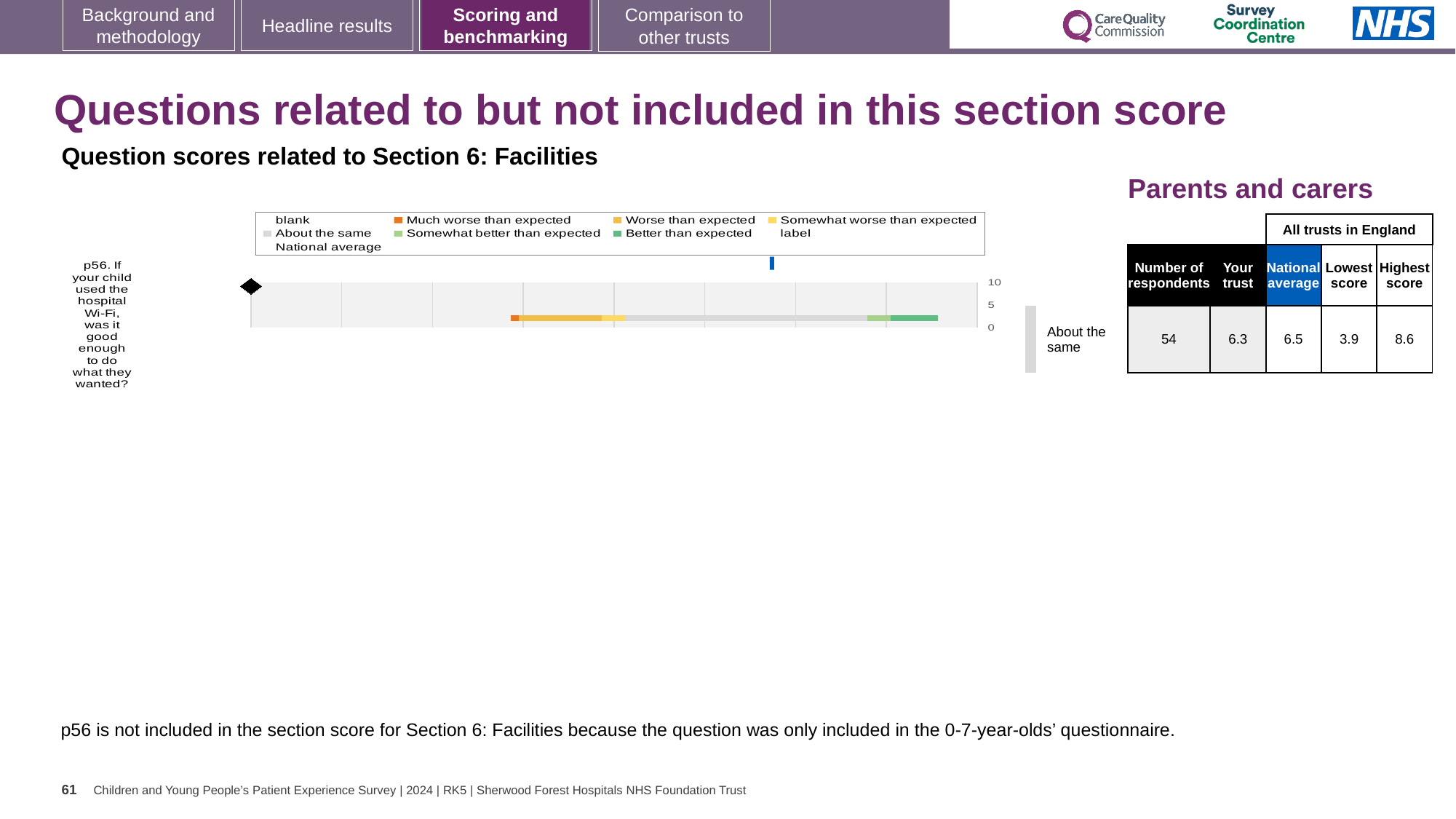
Which benchmarking category is the trust's result for p56 placed in? About the same What is the national average score for p56? 6.5 How many respondents answered p56? 54 What kind of chart is shown on the slide? bar chart How many survey questions are plotted in the chart? 1 What is the difference between the highest and lowest scores for p56 across all trusts in England? 4.7 Is the trust's score for p56 higher or lower than the national average? lower Which question is plotted in the chart? p56. If your child used the hospital Wi-Fi, was it good enough to do what they wanted? What is the 'Your trust' score for p56? 6.3 What is the lowest score among all trusts in England for p56? 3.9 What is the highest score among all trusts in England for p56? 8.6 What is the maximum value shown on the chart's vertical axis? 10